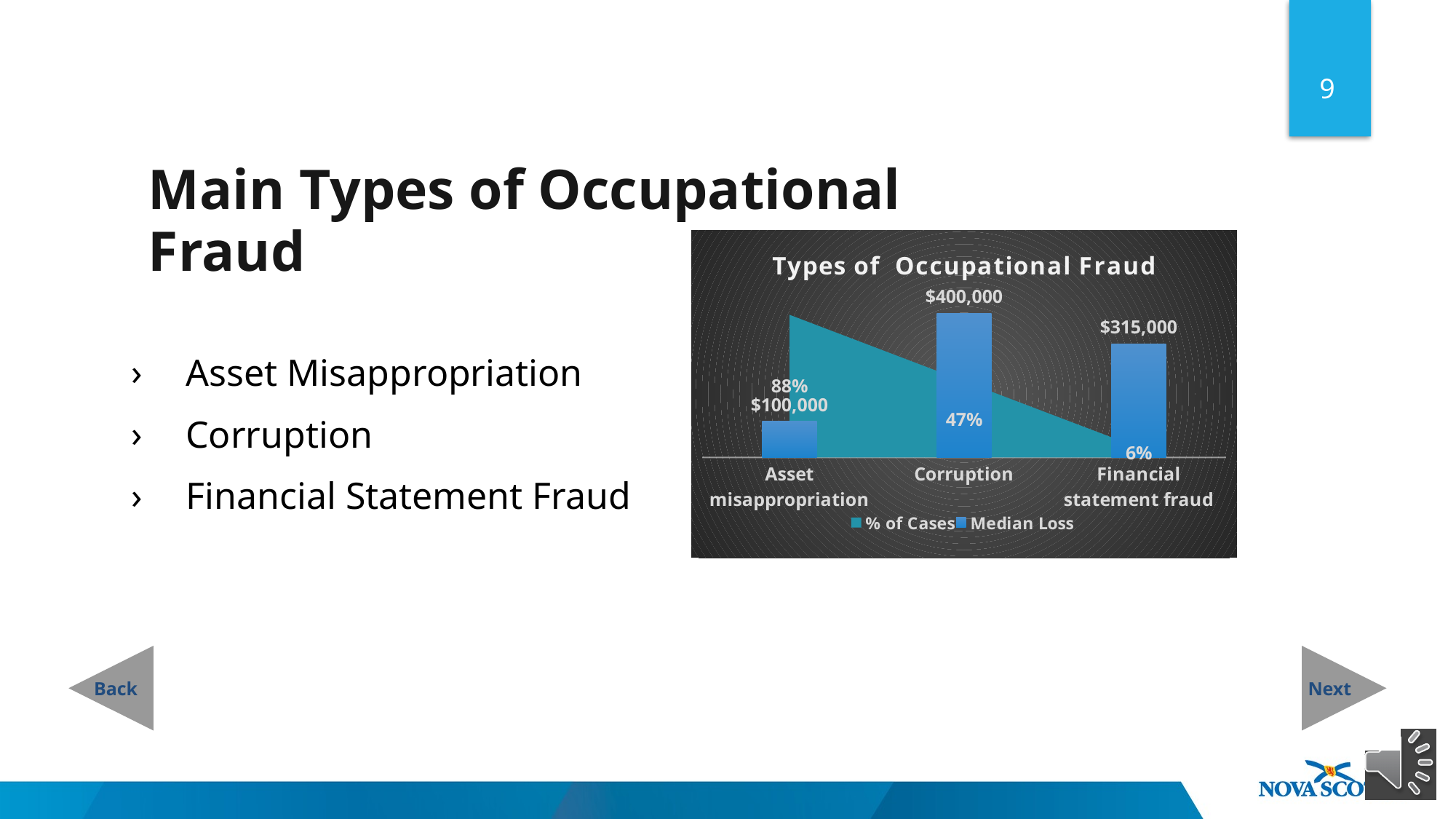
What is the % of Cases for Financial statement fraud? 6% What is the title of the chart on the slide? Types of Occupational Fraud Which has a larger % of Cases, Asset misappropriation or Corruption? Asset misappropriation What is the % of Cases for Asset misappropriation? 88% What is the Median Loss for Financial statement fraud? $315,000 How many series does the chart legend list? 2 Which category has the highest Median Loss? Corruption What is the Median Loss for Corruption? $400,000 What is the Median Loss for Asset misappropriation? $100,000 What is the difference in Median Loss between Corruption and Financial statement fraud? $85,000 Does the % of Cases rise or fall from Asset misappropriation to Financial statement fraud? Fall Which category has the lowest % of Cases? Financial statement fraud